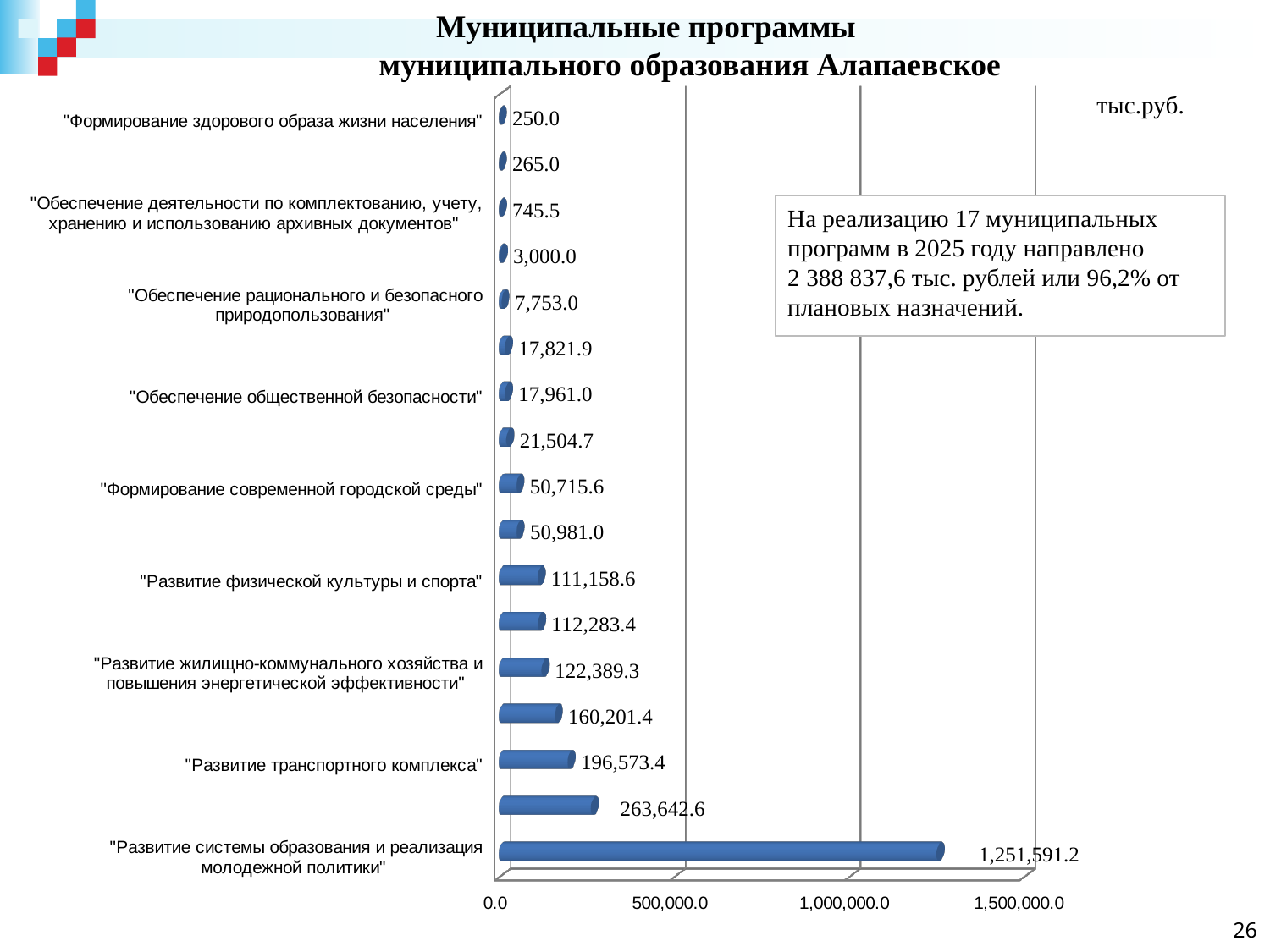
What unit of measurement is indicated for the chart values? тыс.руб. What is the value for "Развитие системы образования и реализация молодежной политики"? 1,251,591.2 Which program has the lowest value? "Формирование здорового образа жизни населения" Which is larger: the value for "Развитие физической культуры и спорта" or for "Формирование современной городской среды"? "Развитие физической культуры и спорта" How many bars are plotted in the chart? 17 What is the difference between the values for "Развитие транспортного комплекса" and "Развитие жилищно-коммунального хозяйства и повышения энергетической эффективности"? 74,184.1 What kind of chart is shown on the slide? bar chart Which program has the highest value? "Развитие системы образования и реализация молодежной политики" What is the value for "Развитие транспортного комплекса"? 196,573.4 Is the value for "Развитие системы образования и реализация молодежной политики" greater or less than 1,000,000.0? greater What is the value for "Обеспечение общественной безопасности"? 17,961.0 What is the value for "Формирование современной городской среды"? 50,715.6